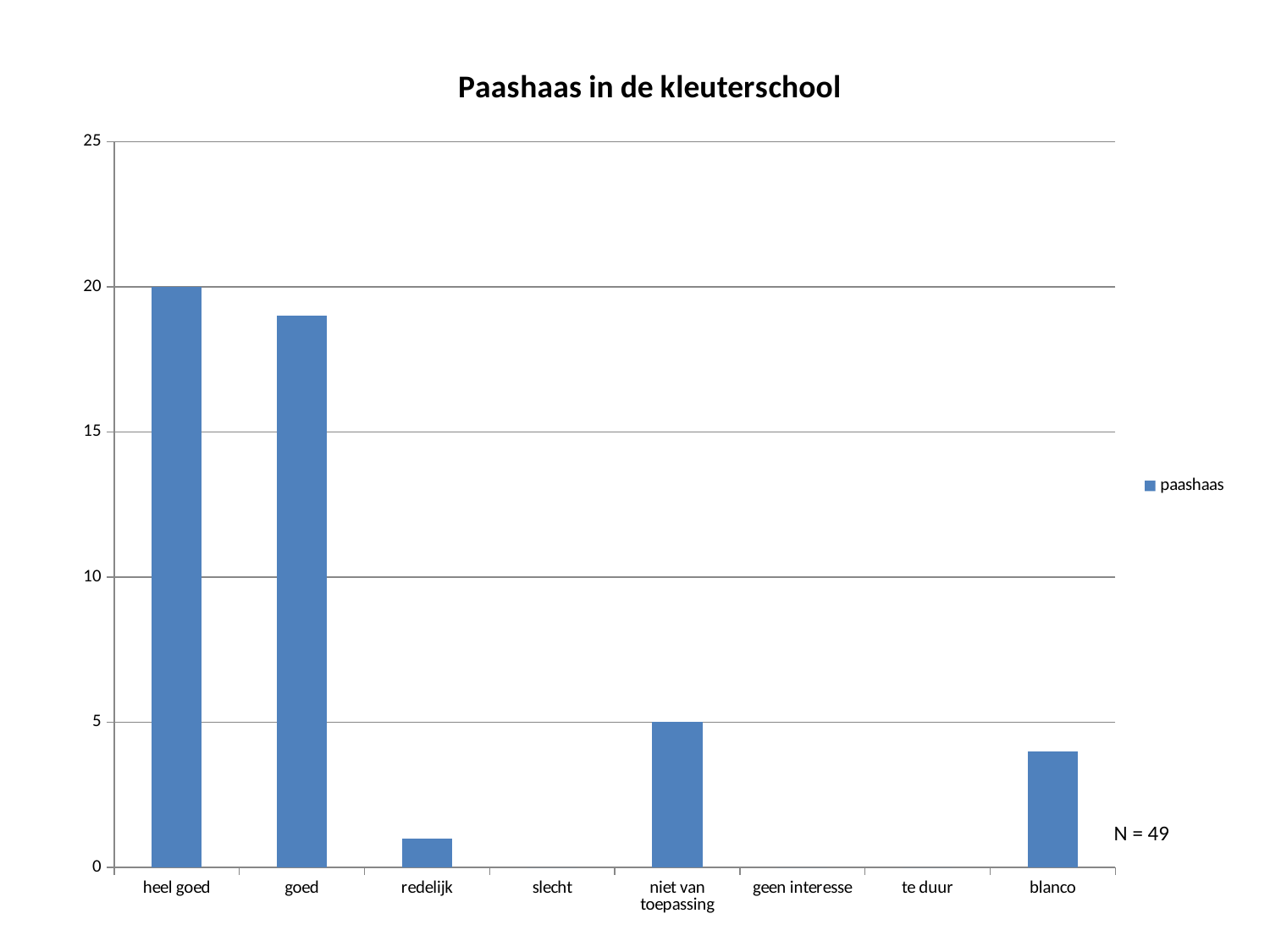
Is the value for 'blanco' greater or less than 5? less How many series does the legend list? 1 How many categories are shown on the x axis? 8 Which category has the highest value? heel goed What is the value for 'niet van toepassing'? 5 What is the difference between the values for 'heel goed' and 'niet van toepassing'? 15 Is the value for 'goed' greater or less than 15? greater Which is larger, the value for 'niet van toepassing' or the value for 'blanco'? niet van toepassing What kind of chart is shown on the slide? bar chart What is the title of the chart? Paashaas in de kleuterschool What is the value for 'heel goed'? 20 Is the value for 'redelijk' greater or less than 5? less